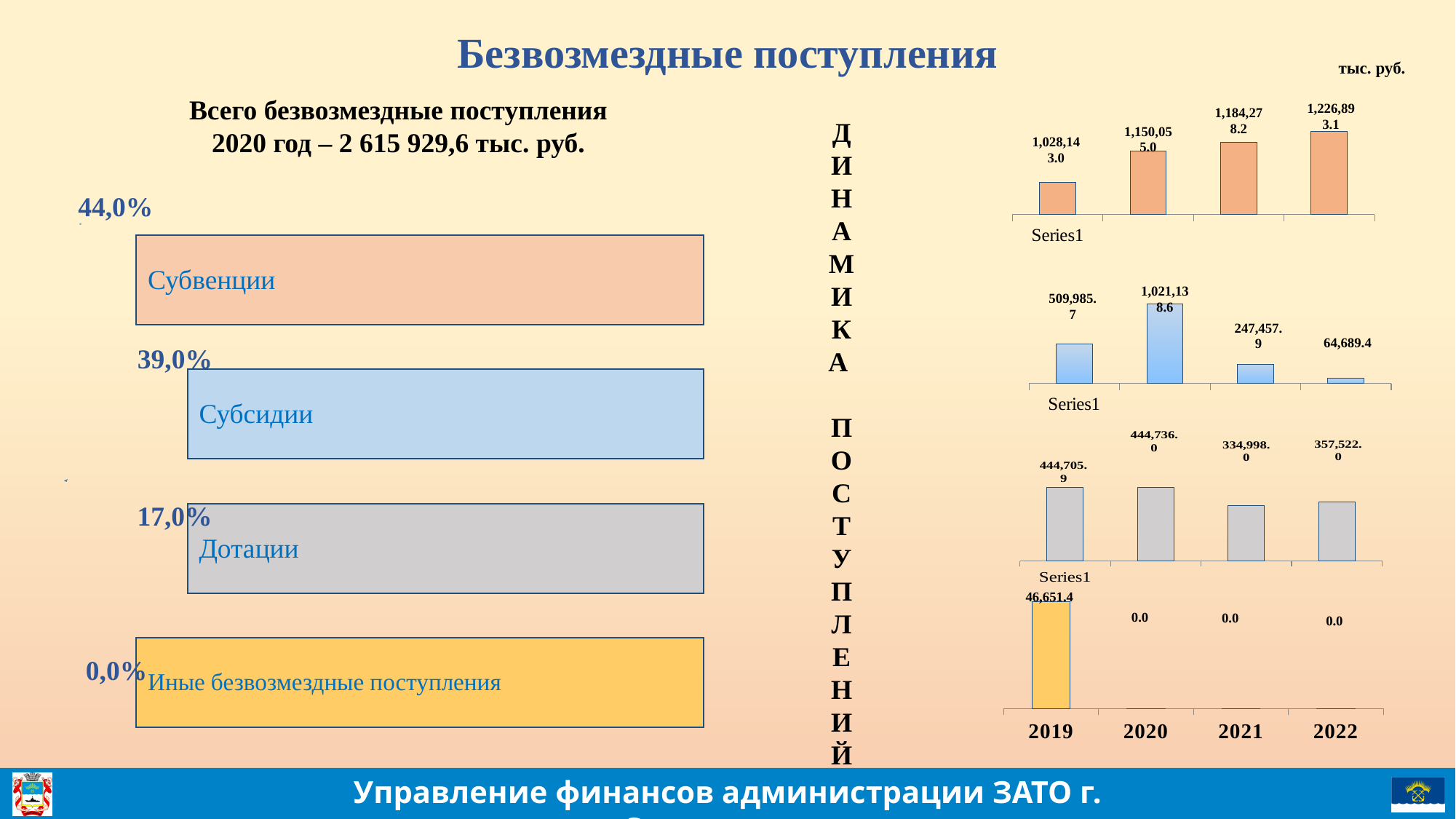
In the third chart from the top on the right (grey bars), what is the difference between the rightmost bar (357,522.0) and the third bar (334,998.0)? 22,524.0 In the top chart on the right (orange bars), what is the value of the rightmost bar (2022 column)? 1,226,893.1 In the top chart on the right (orange bars), do the values rise or fall from left to right? rise In the bottom chart on the right (yellow bar), what is the value for 2019? 46,651.4 In the second chart from the top on the right (blue bars), which bar is the lowest? the rightmost bar (2022 column), 64,689.4 In the second chart from the top on the right (blue bars), what is the value of the third bar (2021 column)? 247,457.9 What kind of chart is the top chart on the right side of the slide (orange bars)? bar chart How many year categories are shown on the x axis of the bottom chart on the right? 4 In the second chart from the top on the right (blue bars), which bar is the highest? the second bar (2020 column), 1,021,138.6 In the top chart on the right (orange bars), what is the difference between the rightmost bar and the leftmost bar? 198,750.1 In the top chart on the right (orange bars), what is the value of the leftmost bar (2019 column)? 1,028,143.0 In the third chart from the top on the right (grey bars), what is the value of the third bar (2021 column)? 334,998.0